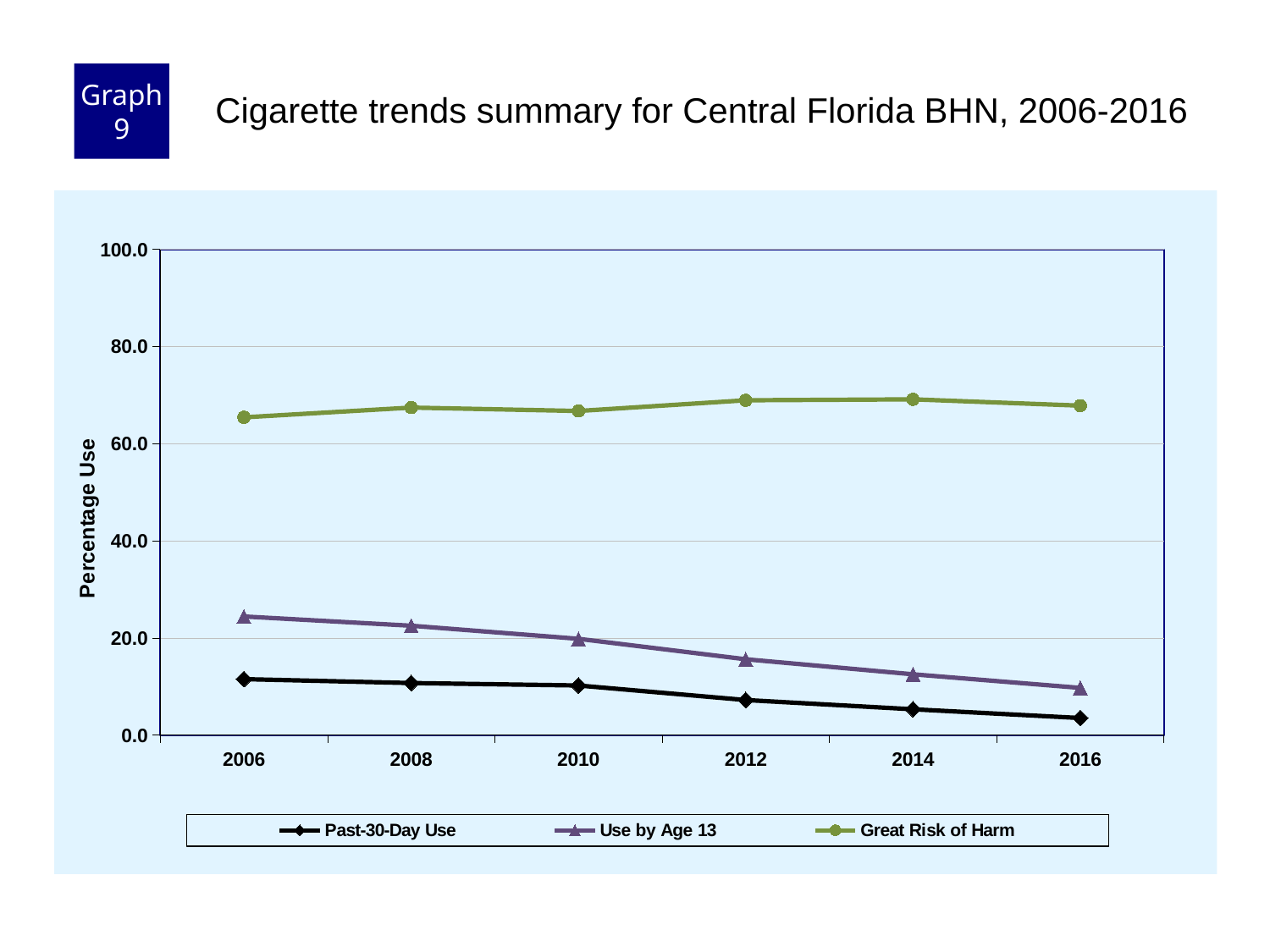
Is the value for Great Risk of Harm in 2006 greater or less than 60.0? greater Is the value for Use by Age 13 in 2016 greater or less than 20.0? less Which series has the highest values across all years? Great Risk of Harm Does the Past-30-Day Use series rise or fall from 2006 to 2016? Fall What is the label on the y axis? Percentage Use How many series does the legend list? 3 Is the value for Use by Age 13 in 2006 greater or less than 20.0? greater Which series has the lowest values across all years? Past-30-Day Use How many years are plotted along the x axis? 6 What kind of chart is shown on the slide? Line chart In 2012, which is larger: Use by Age 13 or Past-30-Day Use? Use by Age 13